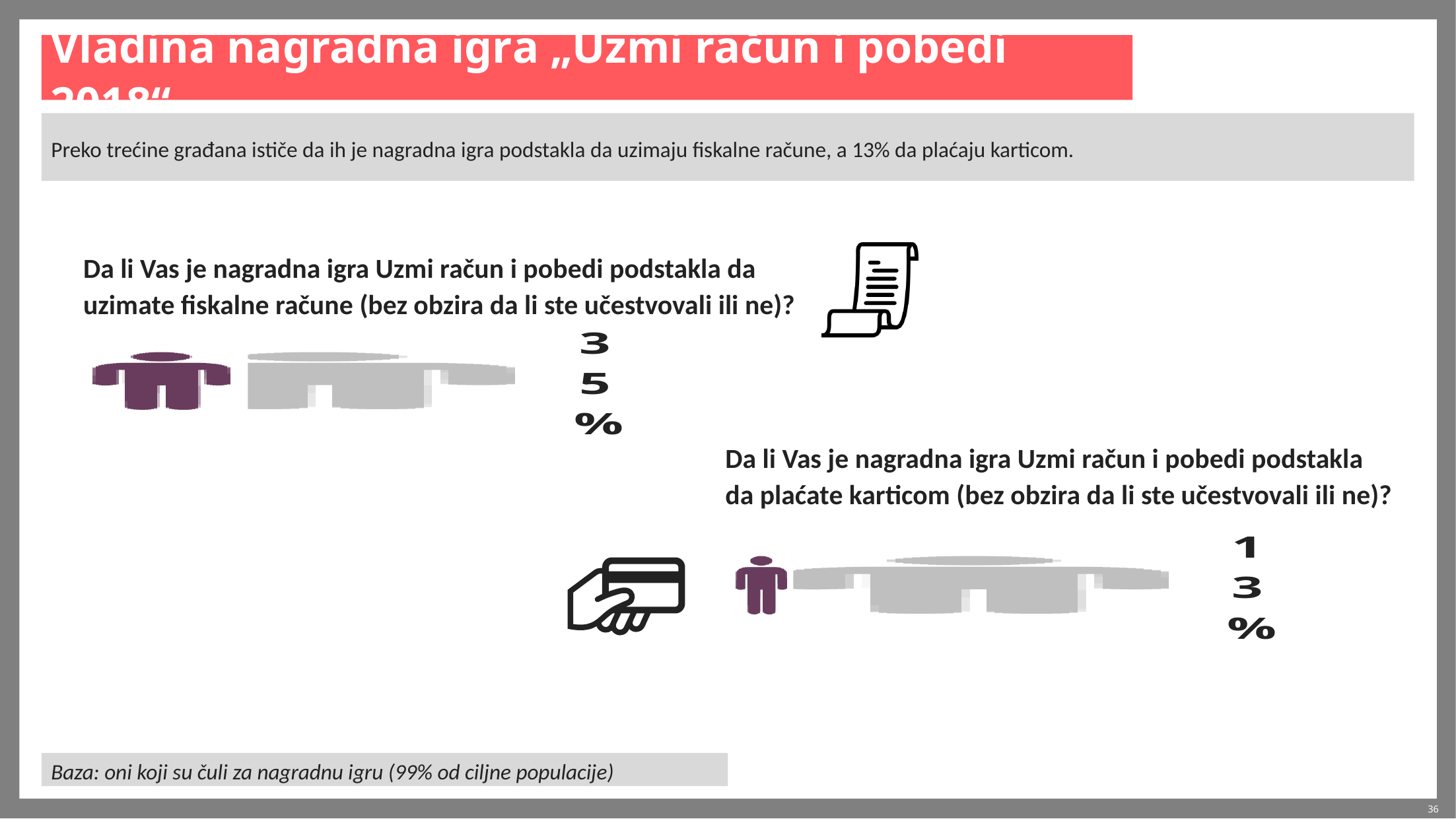
On the chart about taking fiscal receipts, is the value greater or less than 50%? less Which is larger: the share encouraged to take fiscal receipts or the share encouraged to pay by card? Taking fiscal receipts (35%) On the chart about taking fiscal receipts (uzimate fiskalne račune), what percentage of citizens say the prize game encouraged them? 35% What colour are the highlighted person icons representing the share of citizens who were encouraged? Purple According to the note at the bottom, what is the base for the charts? Those who heard of the prize game (99% of the target population) On the chart about paying by card (plaćate karticom), what percentage of citizens say the prize game encouraged them? 13% What kind of chart is used to show the 35% and 13% values on this slide? Pictogram (people icon) chart What is the difference in percentage points between the share encouraged to take fiscal receipts (35%) and the share encouraged to pay by card (13%)? 22 percentage points How many pictogram charts are shown on the slide? 2 On the chart about paying by card, is the value greater or less than 10%? greater